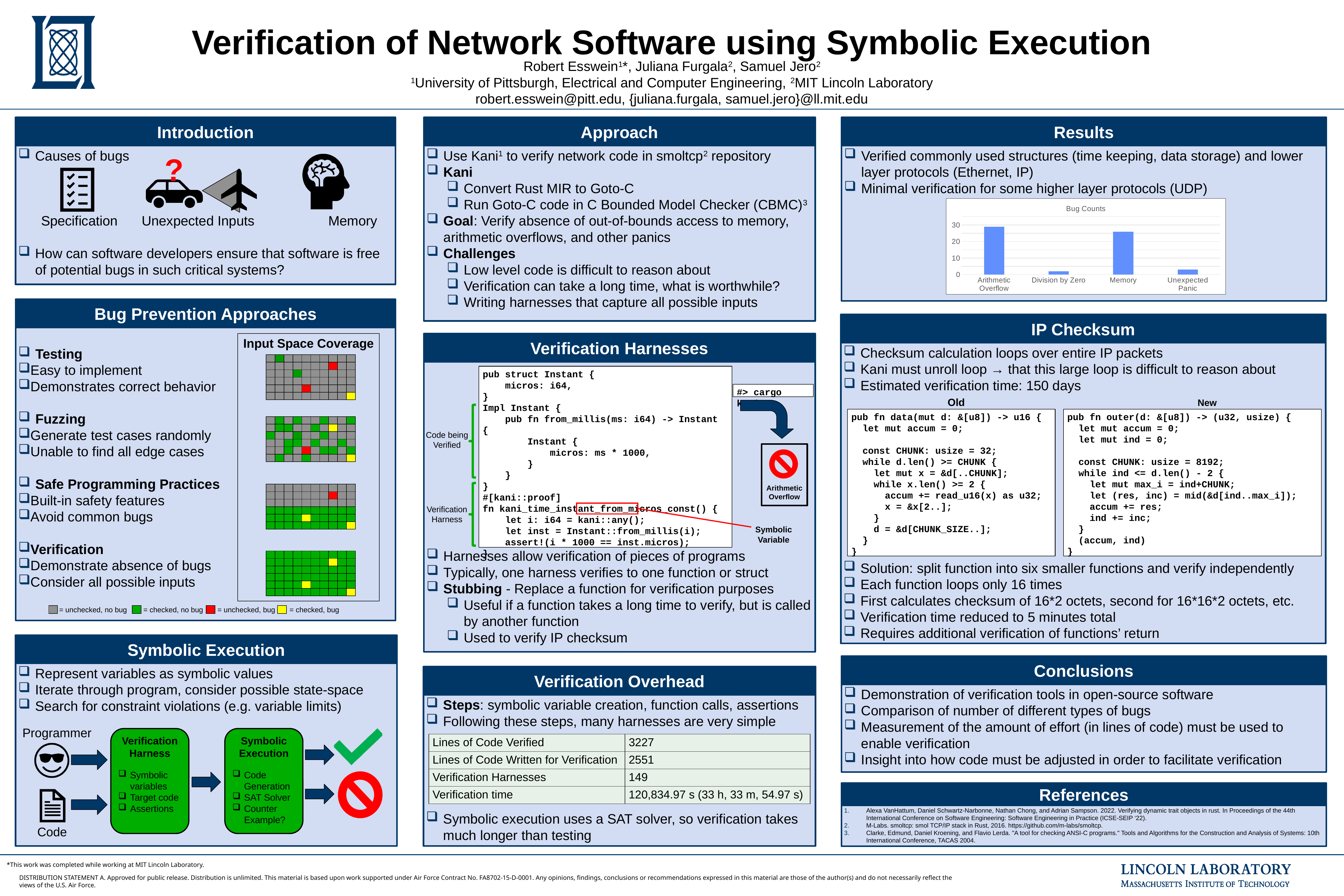
What is the highest tick value shown on the y axis of the Bug Counts chart? 30 Which category has the highest bar in the Bug Counts chart? Arithmetic Overflow Is the value for Division by Zero in the Bug Counts chart greater or less than 10? less How many categories are shown on the Bug Counts chart? 4 Is the value for Memory in the Bug Counts chart greater or less than 30? less What kind of chart is the Bug Counts chart? bar chart In the Bug Counts chart, which is larger: Memory or Unexpected Panic? Memory Is the value for Arithmetic Overflow in the Bug Counts chart greater or less than 20? greater What is the title of the chart in the Results section? Bug Counts In the Bug Counts chart, which is larger: Arithmetic Overflow or Division by Zero? Arithmetic Overflow